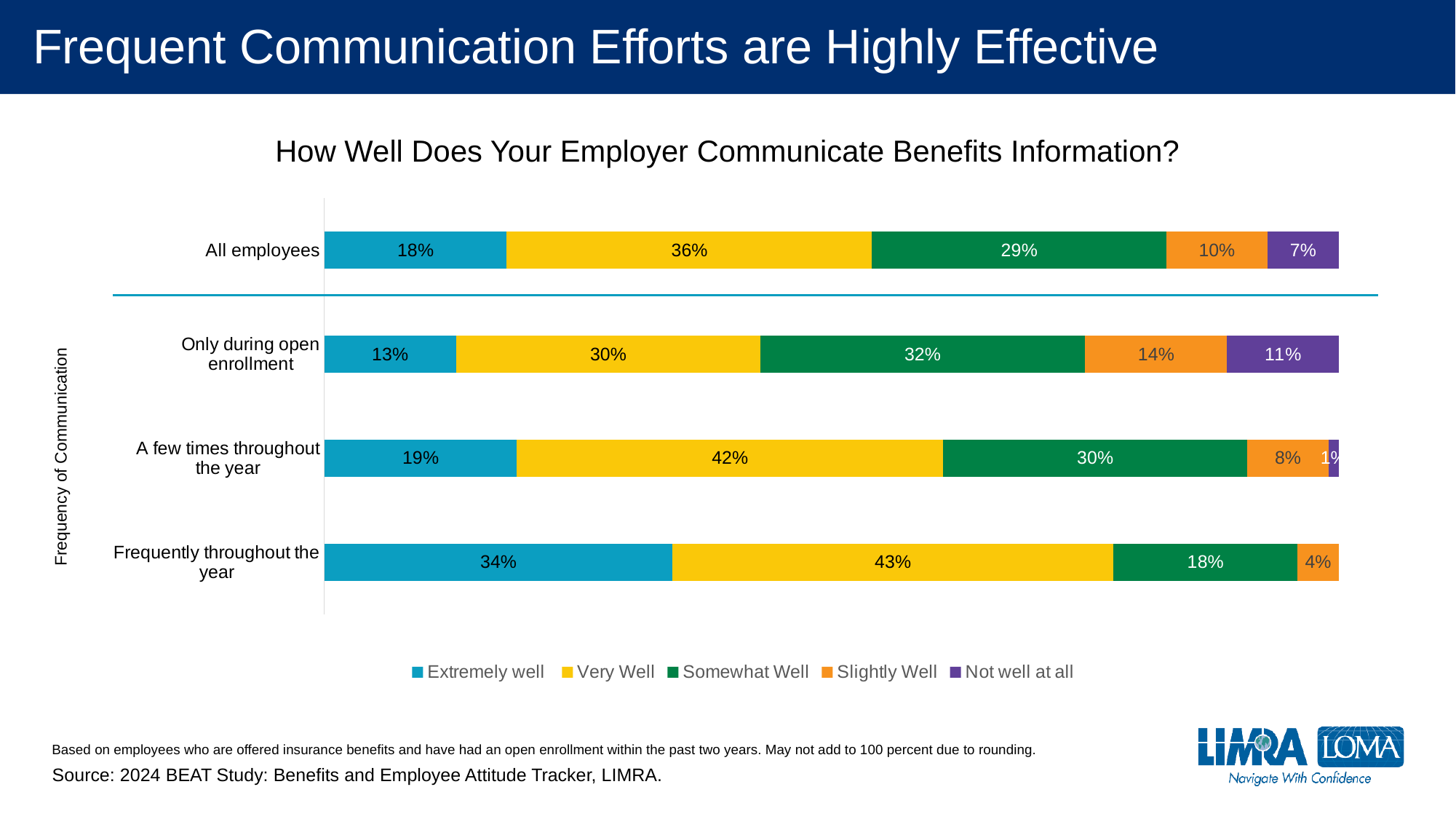
What is the 'Not well at all' value for the 'Only during open enrollment' group? 11% What is the 'Very Well' value for employees whose employer communicates frequently throughout the year? 43% What is the 'Somewhat Well' value for the 'A few times throughout the year' group? 30% How many frequency-of-communication categories are shown in the chart? 3 What percentage of all employees say their employer communicates benefits information extremely well? 18% What is the difference between the 'Extremely well' values for 'Frequently throughout the year' and 'Only during open enrollment'? 21% What is the title of the chart? How Well Does Your Employer Communicate Benefits Information? Which is larger: the 'Slightly Well' value for 'Only during open enrollment' or for 'A few times throughout the year'? Only during open enrollment What type of chart is shown on the slide? Stacked bar chart Which frequency-of-communication group has the highest 'Extremely well' percentage? Frequently throughout the year Which group has the lowest 'Extremely well' percentage? Only during open enrollment How many series does the legend list? 5